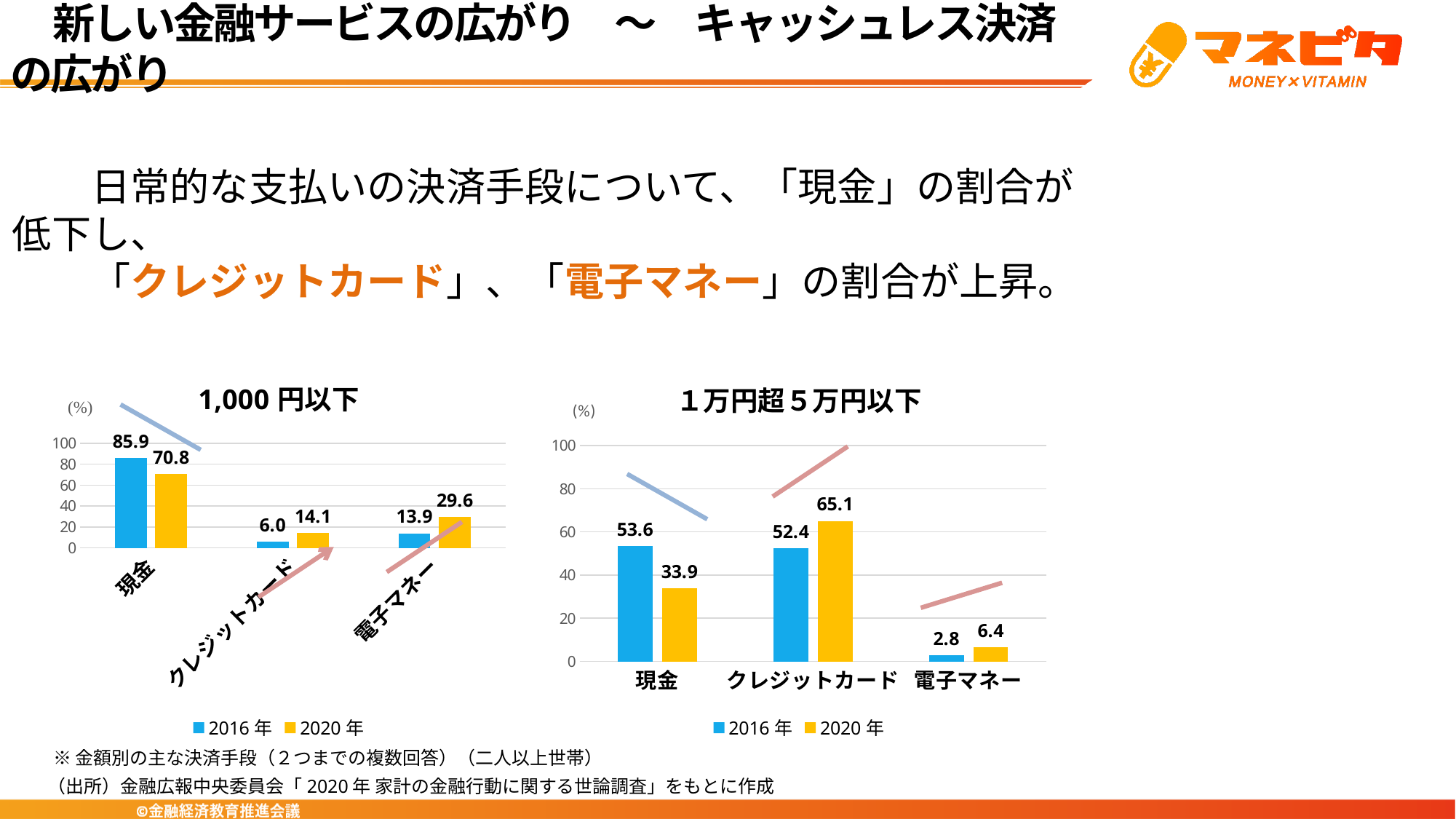
In the "1,000円以下" chart, what is the value for 電子マネー in 2020年? 29.6 In the "１万円超５万円以下" chart, what is the difference between the 2020年 and 2016年 values for クレジットカード? 12.7 In the "1,000円以下" chart, what is the value for 現金 in 2016年? 85.9 In the "1,000円以下" chart, which category has the lowest value in 2016年? クレジットカード How many series does the legend of the "１万円超５万円以下" chart list? 2 In the "１万円超５万円以下" chart, what is the value for クレジットカード in 2020年? 65.1 In the "1,000円以下" chart, what is the difference between the 2016年 and 2020年 values for 現金? 15.1 What kind of chart is the "1,000円以下" chart? Bar chart In the "１万円超５万円以下" chart, which category has the highest value in 2020年? クレジットカード How many categories are shown on the x axis of the "1,000円以下" chart? 3 In the "１万円超５万円以下" chart, what is the value for 電子マネー in 2016年? 2.8 In the "１万円超５万円以下" chart, which is larger for 現金: the 2016年 value or the 2020年 value? 2016年